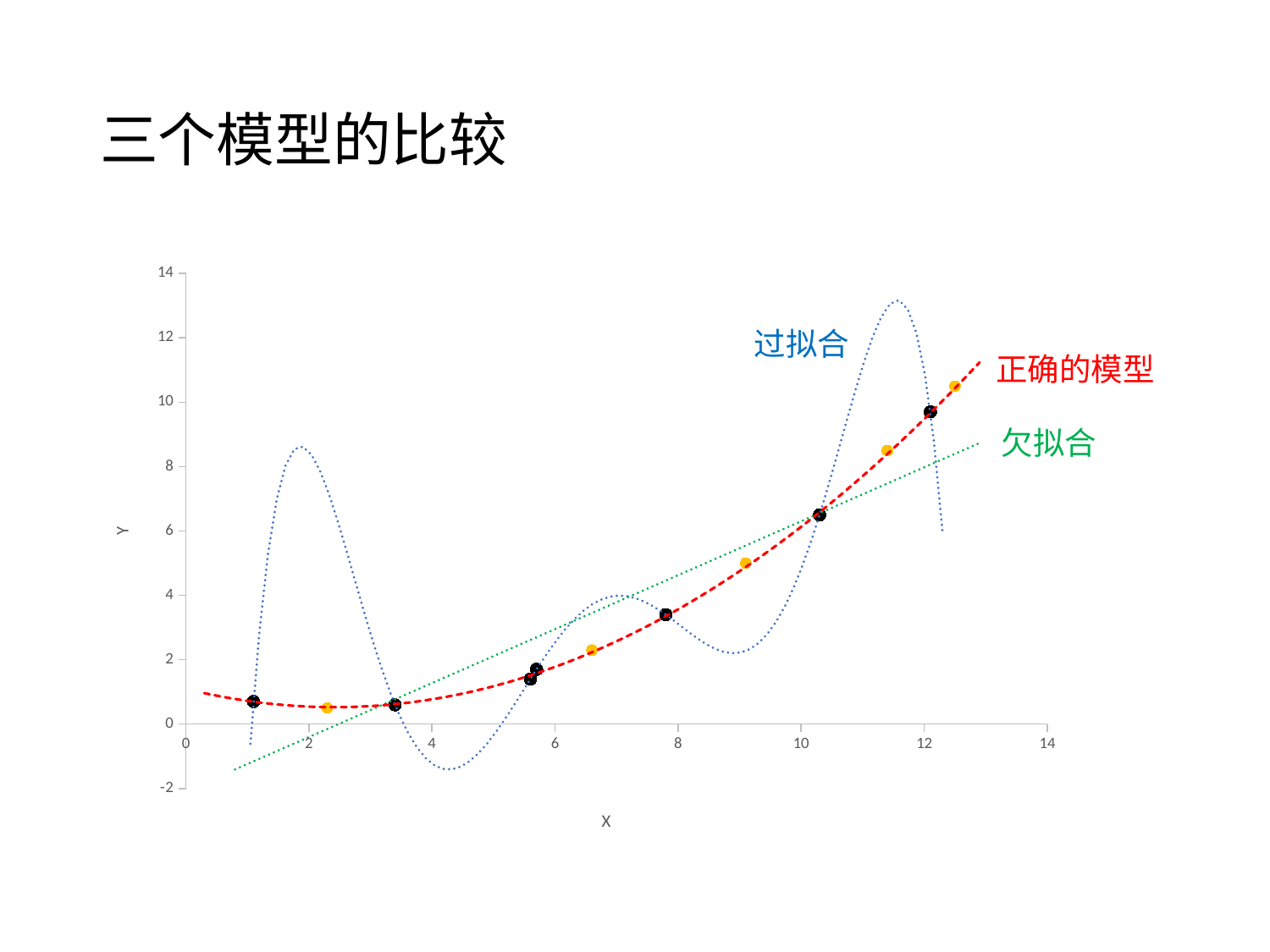
What is the title of the slide above the chart? 三个模型的比较 What label is written on the horizontal axis of the chart? X What is the label of the red dashed curve? 正确的模型 Is the Y value of the data point near X = 1 greater or less than 2? less Is the highest peak of the blue dotted curve (过拟合) greater or less than 12 on the Y axis? greater Does the red dashed curve (正确的模型) generally rise or fall as X increases from 4 to 12? rise Is the Y value of the data point near X = 12 greater or less than 8? greater Which has a higher Y value: the data point near X = 10 or the data point near X = 6? the data point near X = 10 What kind of chart is shown on the slide? scatter chart